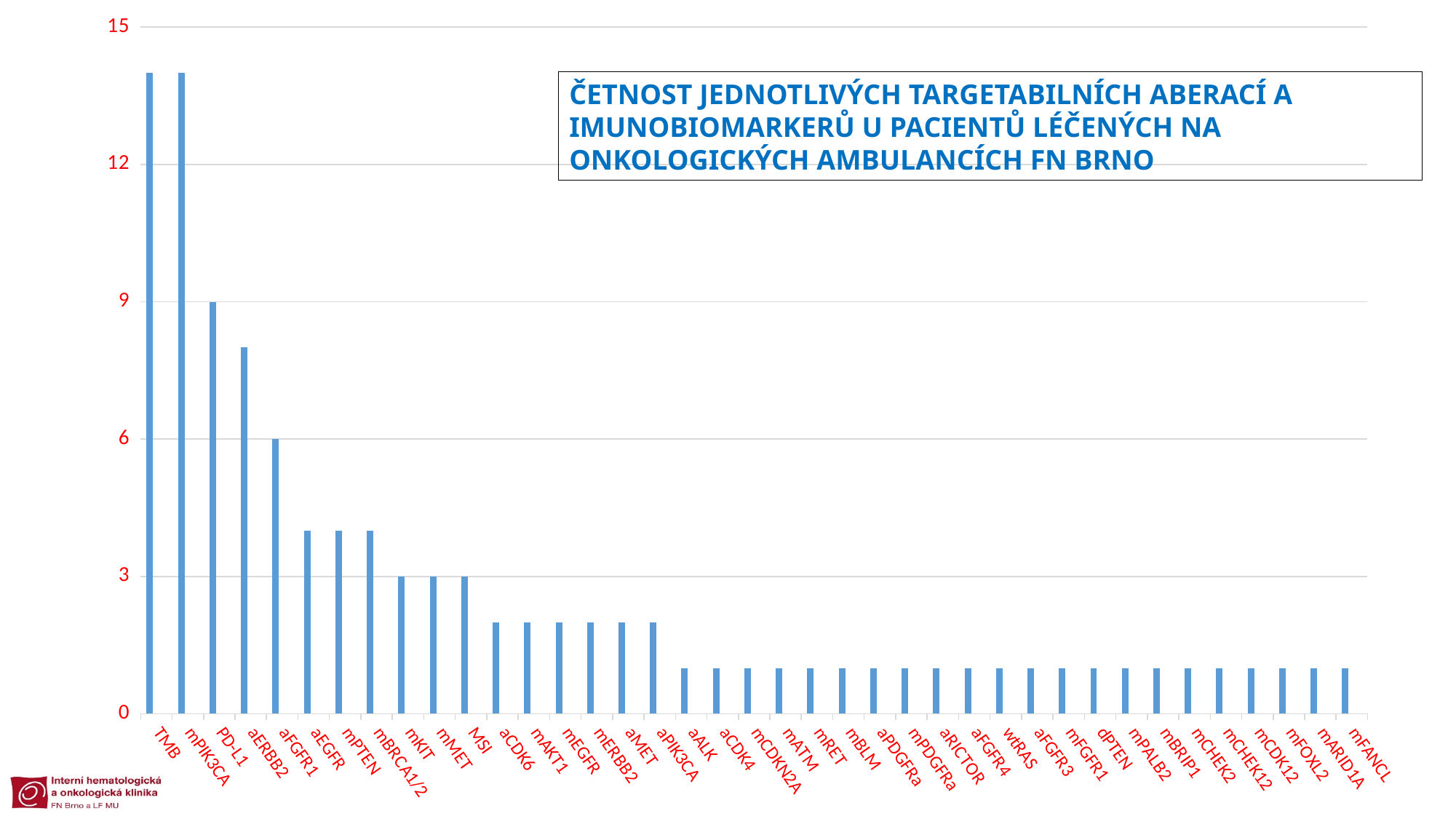
Is the value for TMB greater or less than 12? greater Is the value for aERBB2 greater or less than 9? less Which has a larger value, PD-L1 or aERBB2? PD-L1 What is the value for PD-L1? 9 Is the value for aEGFR greater or less than 3? greater Which has a larger value, aFGFR1 or mPTEN? aFGFR1 What is the value for MSI? 3 Do the values generally rise or fall from left to right along the x axis? fall What type of chart is shown on the slide? bar chart What is the value for mKIT? 3 What is the value for aFGFR1? 6